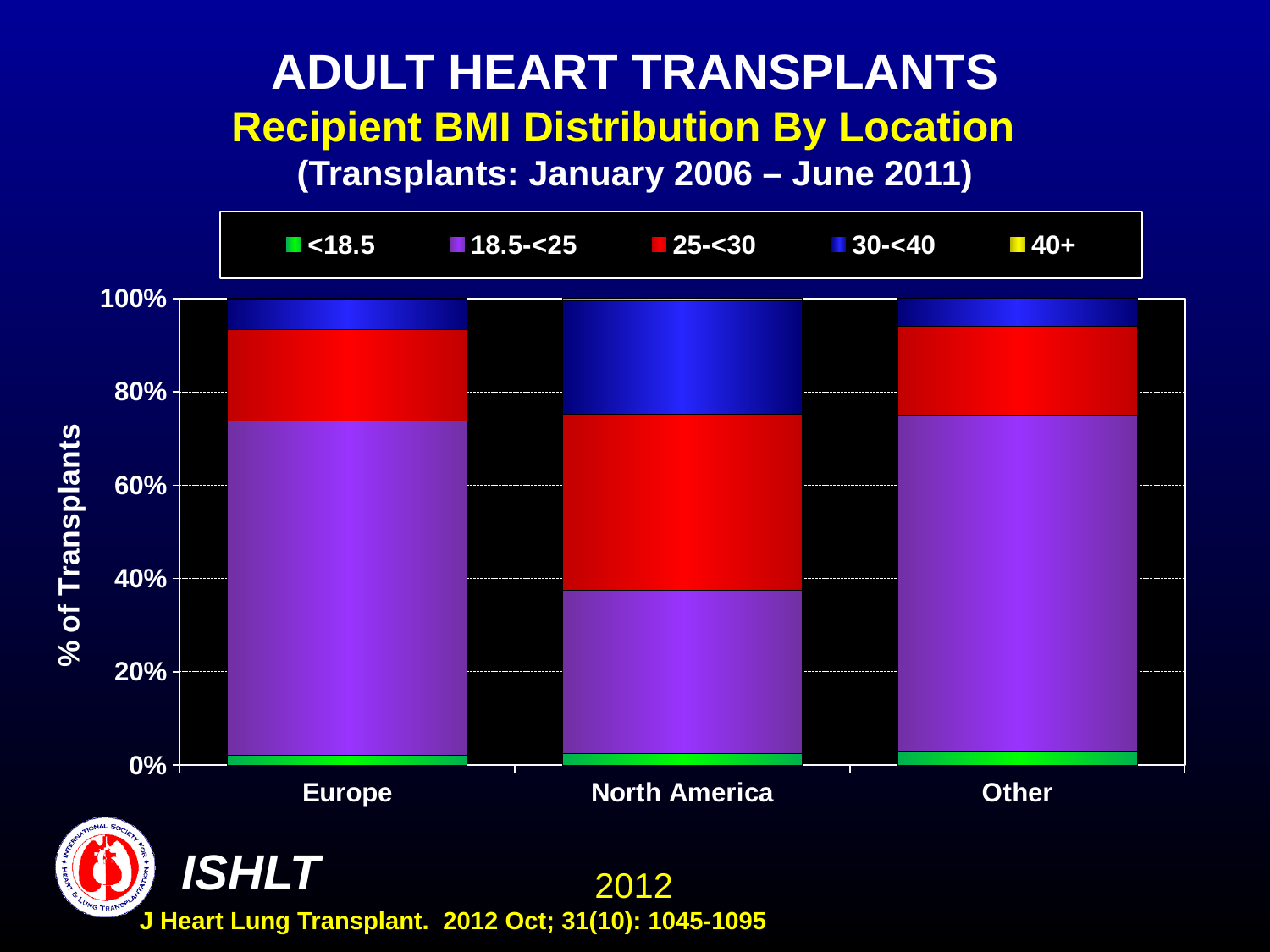
What is the label on the y axis? % of Transplants How many BMI categories does the legend list? 5 Which location has a larger share of recipients with BMI 25-<30, Europe or North America? North America Which location has a larger share of recipients with BMI 18.5-<25, Europe or North America? Europe How many locations are shown on the x axis? 3 Is the share of recipients with BMI 18.5-<25 in North America greater or less than 40%? less Which location has the largest share of recipients with BMI 30-<40? North America Is the share of recipients with BMI 18.5-<25 in Other greater or less than 60%? greater What kind of chart is shown on the slide? stacked bar chart What transplant date range is given in the chart title? January 2006 – June 2011 Is the share of recipients with BMI 18.5-<25 in Europe greater or less than 60%? greater Which location has the smallest share of recipients with BMI 18.5-<25? North America